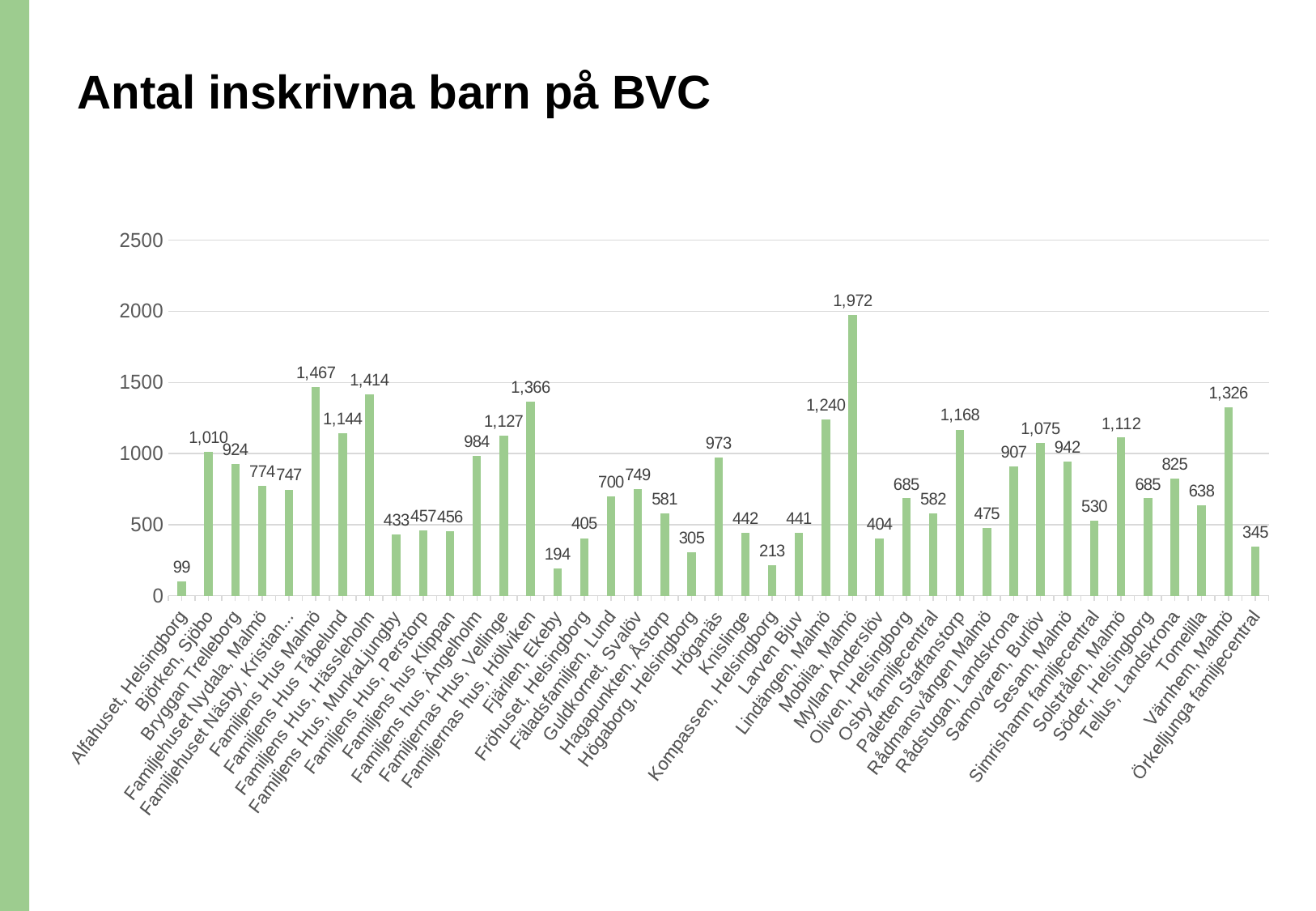
Which category has the lowest value? Alfahuset, Helsingborg What is the value for Höganäs? 973 Is the value for Paletten Staffanstorp greater or less than 1000? greater What is the value for Fjärilen, Ekeby? 194 Which category has the highest value? Mobilia, Malmö What is the title of the chart? Antal inskrivna barn på BVC What is the difference between the values for Värnhem, Malmö and Lindängen, Malmö? 86 What is the difference between the values for Mobilia, Malmö and Alfahuset, Helsingborg? 1,873 What is the value for Mobilia, Malmö? 1,972 Which is larger, the value for Björken, Sjöbo or the value for Bryggan Trelleborg? Björken, Sjöbo What is the value for Familjens Hus Malmö? 1,467 What kind of chart is shown on the slide? bar chart